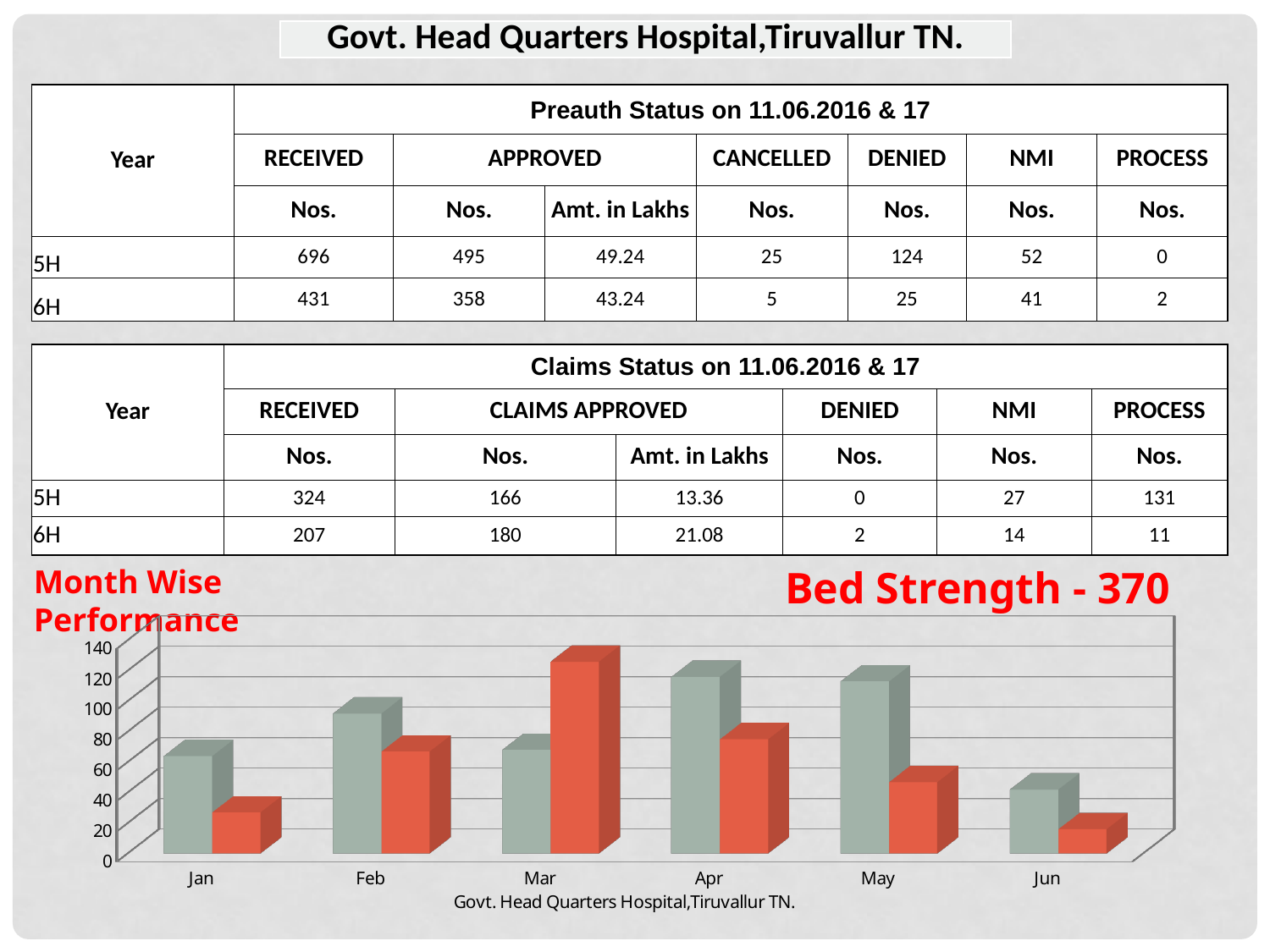
How many bars are plotted for each month in the chart? 2 Is the value of the orange bar for Jan greater or less than 40? less In which month is the grey bar the shortest? Jun What kind of chart is shown on the slide? bar chart In which month is the orange bar the shortest? Jun How many months are shown on the x axis of the chart? 6 In which month is the orange bar the tallest? Mar Is the value of the grey bar for Apr greater or less than 100? greater In Mar, which bar is taller, the grey bar or the orange bar? orange bar What title is printed beneath the chart? Govt. Head Quarters Hospital,Tiruvallur TN. In Jan, which bar is taller, the grey bar or the orange bar? grey bar Is the value of the orange bar for Mar greater or less than 100? greater